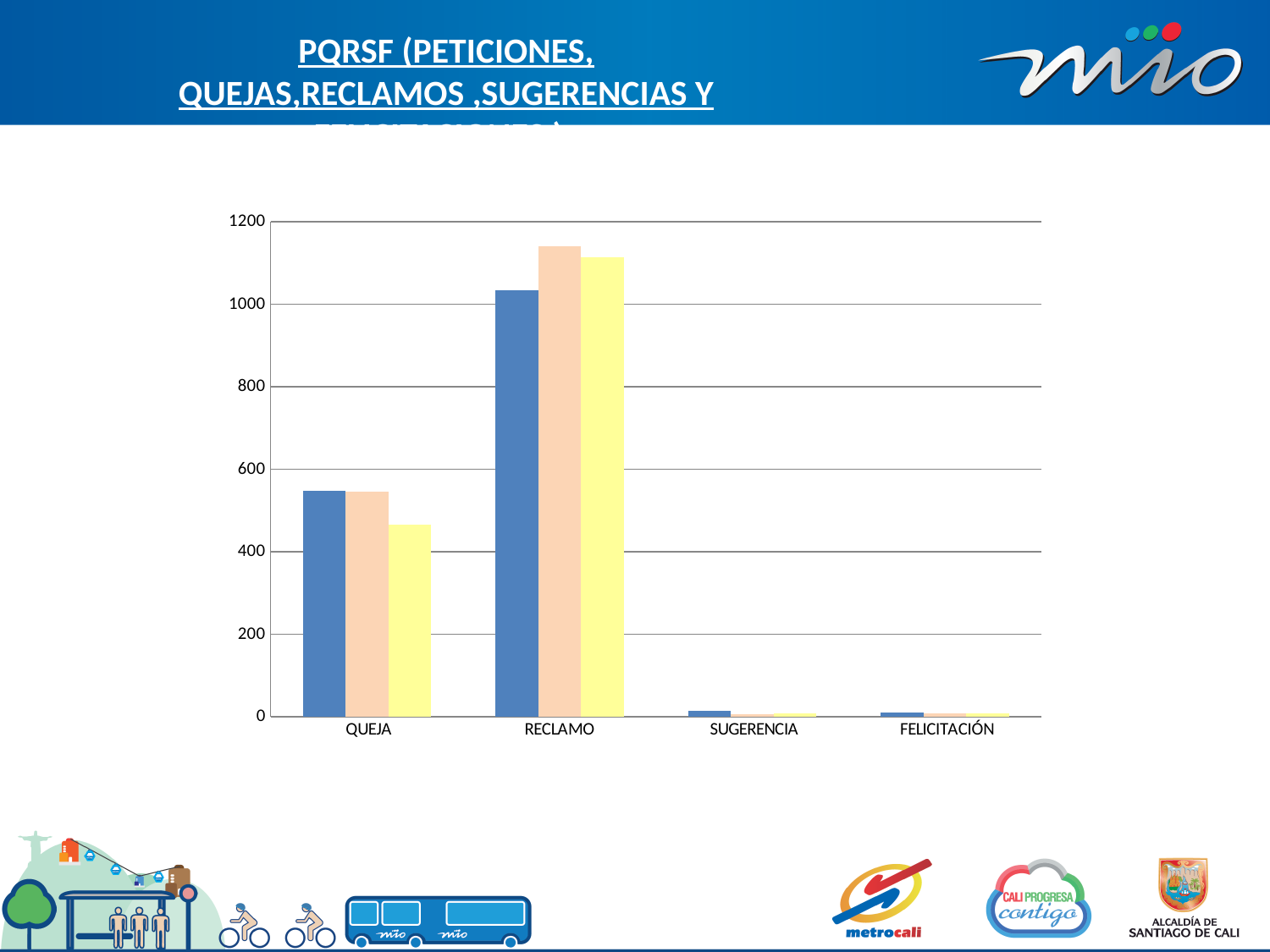
Within the QUEJA category, which is larger, the blue bar or the yellow bar? the blue bar Is the value of the blue bar for SUGERENCIA greater or less than 200? less Is the value of the blue bar for QUEJA greater or less than 400? greater Is the value of the blue bar for RECLAMO greater or less than 1200? less How many bars are plotted for each category in the chart? 3 What kind of chart is shown on the slide? bar chart How many categories are shown on the x axis of the chart? 4 Which is larger, the blue bar for QUEJA or the blue bar for RECLAMO? RECLAMO Which category has the tallest bars in the chart? RECLAMO Within the RECLAMO category, which is larger, the blue bar or the peach bar? the peach bar